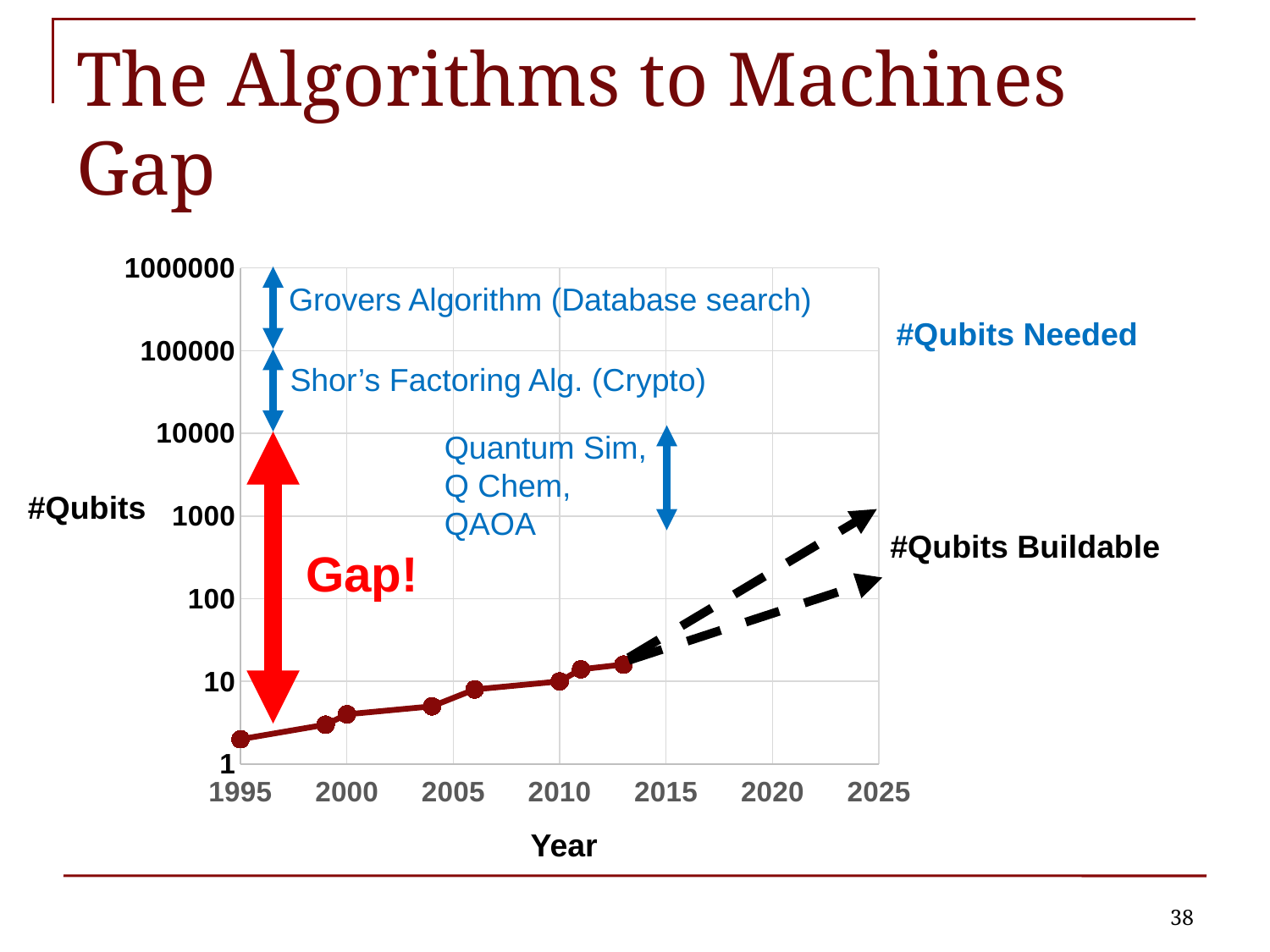
Is the #Qubits value plotted at 1995 greater or less than 10? less What is the label on the x axis? Year Is the #Qubits value of the last plotted point (around 2013) greater or less than 100? less Is the #Qubits value of the last plotted point (around 2013) greater or less than 10? greater What is the highest tick value shown on the y axis? 1000000 Which plotted point has the highest #Qubits value, the one at 1995 or the one around 2013? the one around 2013 What kind of chart is shown on the slide? line chart How many data points are plotted on the solid line? 8 Do the plotted #Qubits values rise or fall as the year increases from 1995 to 2013? rise Which year's plotted point has the lowest #Qubits value? 1995